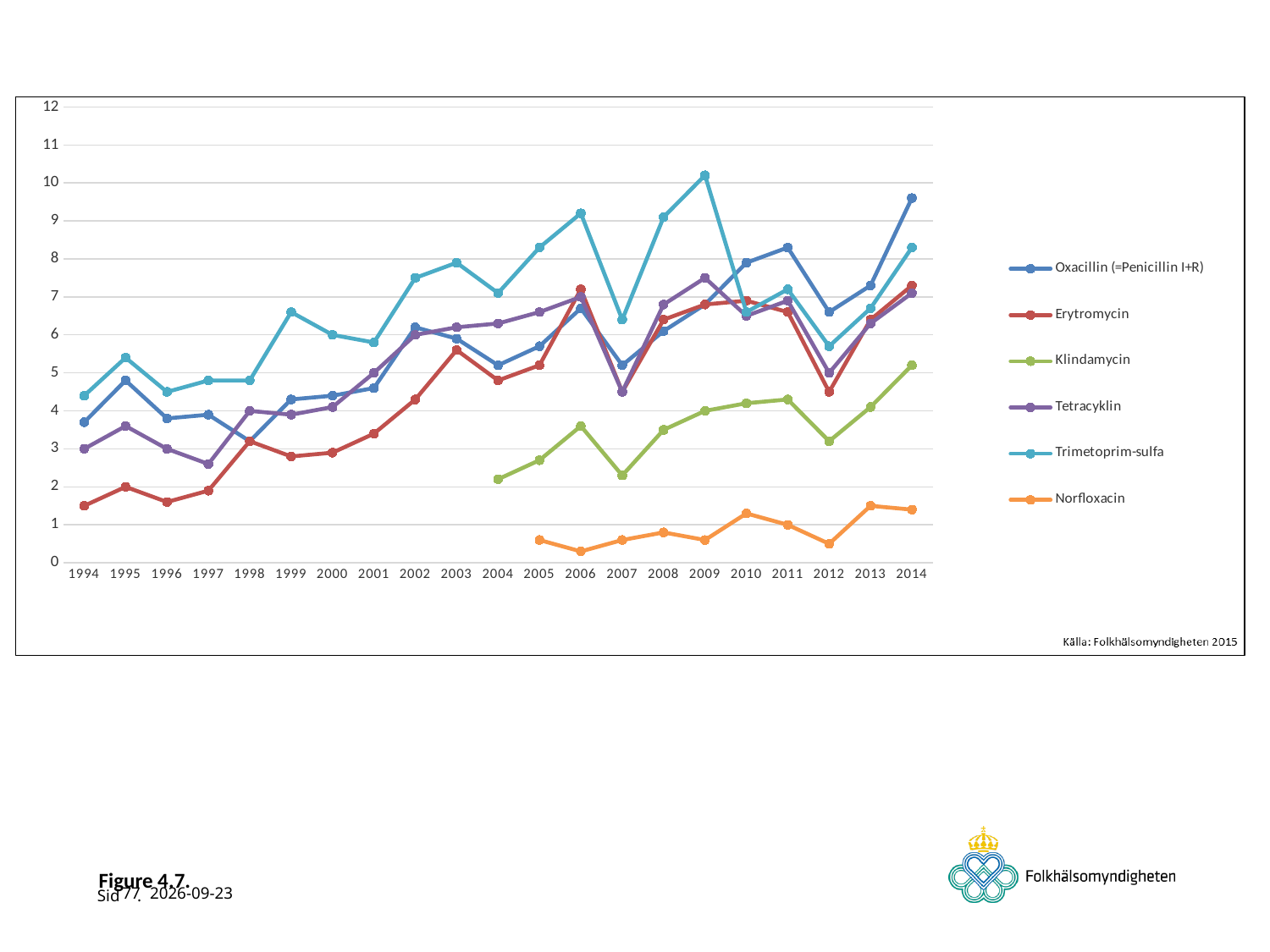
Which series has the highest value in 2009? Trimetoprim-sulfa Is the value for Oxacillin (=Penicillin I+R) in 2014 greater or less than 9? greater How many series does the legend list? 6 In 1994, which is higher: Oxacillin (=Penicillin I+R) or Erytromycin? Oxacillin (=Penicillin I+R) In which year does Trimetoprim-sulfa reach its highest value? 2009 Which series has the lowest value in 2014? Norfloxacin What source is cited at the bottom right of the chart? Källa: Folkhälsomyndigheten 2015 Is the value for Norfloxacin in 2006 greater or less than 1? less How many years are shown along the x axis? 21 Is the value for Tetracyklin in 1997 greater or less than 3? less What kind of chart is shown on the slide? line chart